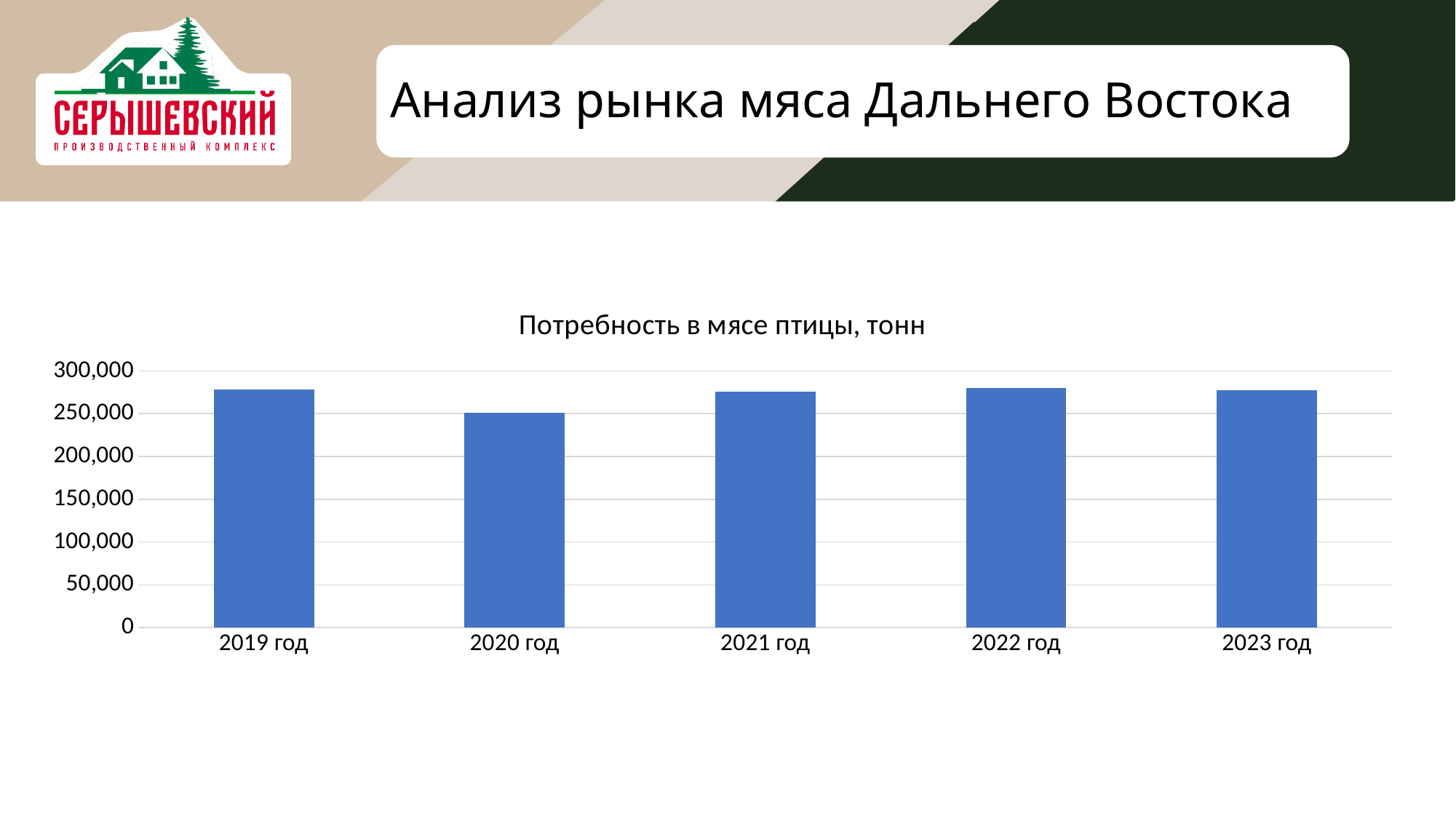
Does the value rise or fall from 2019 год to 2020 год? fall What kind of chart is shown on the slide? bar chart How many years (bars) are shown in the chart? 5 Is the value for 2020 год greater or less than 300,000? less Is the value for 2022 год greater or less than 250,000? greater What is the title of the chart? Потребность в мясе птицы, тонн Is the value for 2023 год greater or less than 300,000? less Which year has the lowest value in the chart? 2020 год Which is larger, the value for 2020 год or the value for 2022 год? 2022 год Which is larger, the value for 2019 год or the value for 2020 год? 2019 год